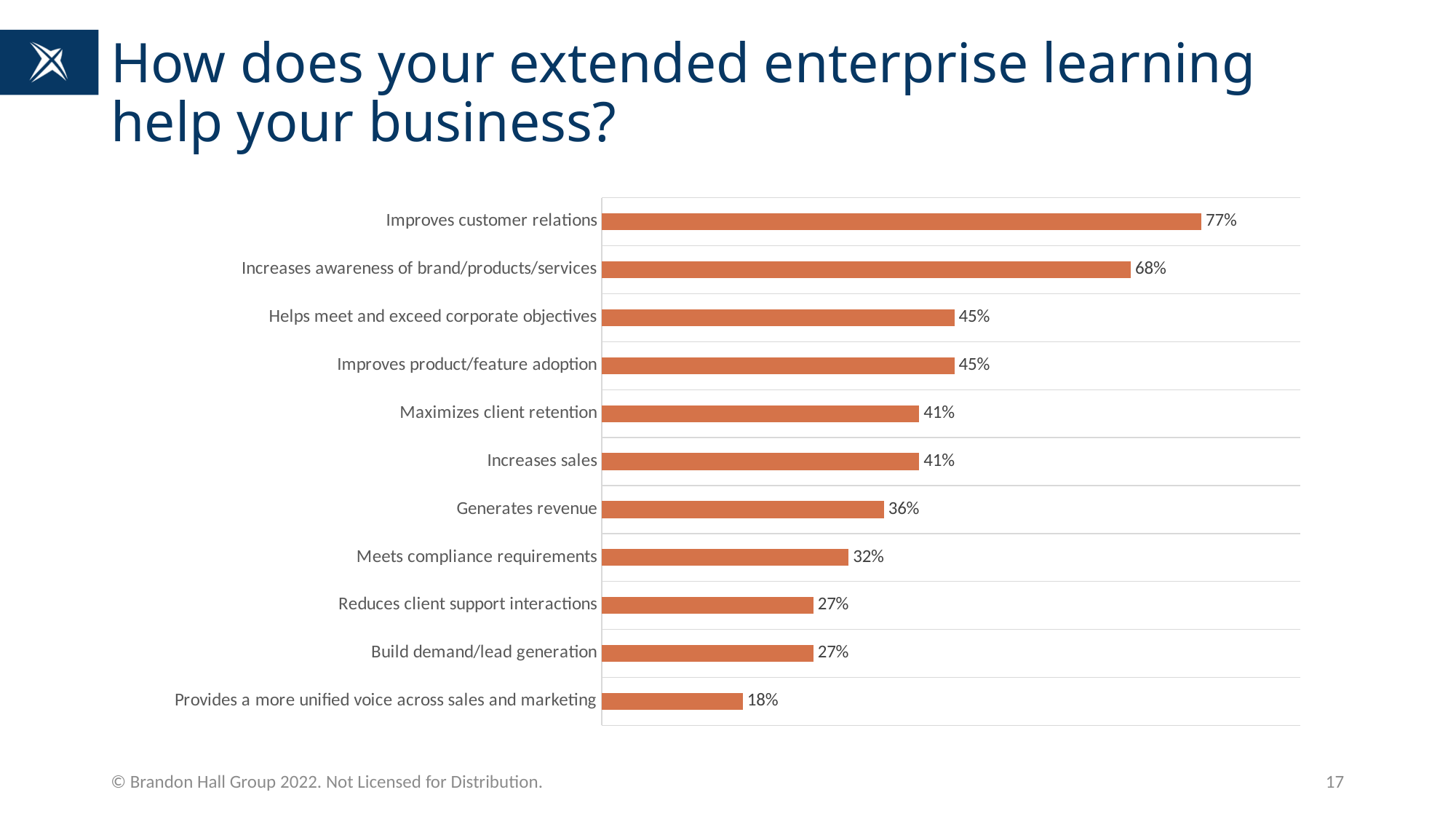
What value is shown for "Provides a more unified voice across sales and marketing"? 18% Which category has the highest value? Improves customer relations What is the difference between "Improves customer relations" and "Increases awareness of brand/products/services"? 9% What colour are the bars in the chart? Orange Which is larger: "Helps meet and exceed corporate objectives" or "Meets compliance requirements"? Helps meet and exceed corporate objectives What is the difference between "Maximizes client retention" and "Generates revenue"? 5% What kind of chart is shown on the slide? Bar chart How many categories are shown in the chart? 11 What percentage is shown for "Meets compliance requirements"? 32% What value is shown for "Generates revenue"? 36% What percentage is shown for "Improves customer relations"? 77% Which category has the lowest value? Provides a more unified voice across sales and marketing